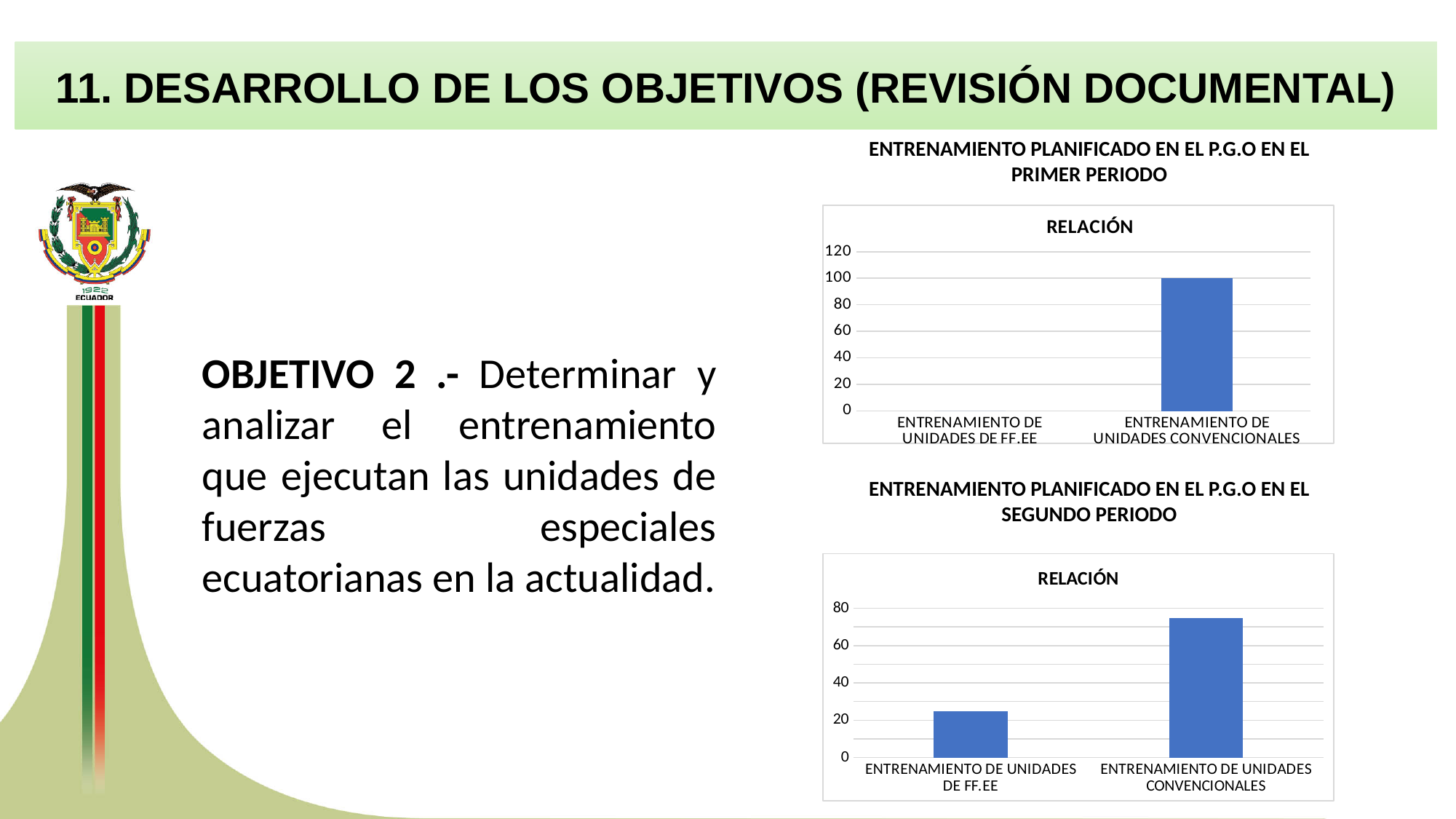
In the chart titled 'ENTRENAMIENTO PLANIFICADO EN EL P.G.O EN EL SEGUNDO PERIODO', is the value for ENTRENAMIENTO DE UNIDADES CONVENCIONALES greater or less than 60? greater In the chart titled 'ENTRENAMIENTO PLANIFICADO EN EL P.G.O EN EL SEGUNDO PERIODO', which category has the lowest value? ENTRENAMIENTO DE UNIDADES DE FF.EE In the chart titled 'ENTRENAMIENTO PLANIFICADO EN EL P.G.O EN EL PRIMER PERIODO', what kind of chart is shown? bar chart In the chart titled 'ENTRENAMIENTO PLANIFICADO EN EL P.G.O EN EL SEGUNDO PERIODO', is the value for ENTRENAMIENTO DE UNIDADES DE FF.EE greater or less than 40? less In the chart titled 'ENTRENAMIENTO PLANIFICADO EN EL P.G.O EN EL PRIMER PERIODO', how many categories are shown on the x axis? 2 In the chart titled 'ENTRENAMIENTO PLANIFICADO EN EL P.G.O EN EL PRIMER PERIODO', what is the value for ENTRENAMIENTO DE UNIDADES CONVENCIONALES? 100 In the chart titled 'ENTRENAMIENTO PLANIFICADO EN EL P.G.O EN EL SEGUNDO PERIODO', what kind of chart is shown? bar chart In the chart titled 'ENTRENAMIENTO PLANIFICADO EN EL P.G.O EN EL PRIMER PERIODO', which category has the highest value? ENTRENAMIENTO DE UNIDADES CONVENCIONALES What title is printed inside the plot area of the chart titled 'ENTRENAMIENTO PLANIFICADO EN EL P.G.O EN EL PRIMER PERIODO'? RELACIÓN In the chart titled 'ENTRENAMIENTO PLANIFICADO EN EL P.G.O EN EL SEGUNDO PERIODO', which is larger: the value for ENTRENAMIENTO DE UNIDADES DE FF.EE or for ENTRENAMIENTO DE UNIDADES CONVENCIONALES? ENTRENAMIENTO DE UNIDADES CONVENCIONALES In the chart titled 'ENTRENAMIENTO PLANIFICADO EN EL P.G.O EN EL SEGUNDO PERIODO', how many bars are plotted? 2 In the chart titled 'ENTRENAMIENTO PLANIFICADO EN EL P.G.O EN EL PRIMER PERIODO', is the value for ENTRENAMIENTO DE UNIDADES CONVENCIONALES greater or less than 80? greater